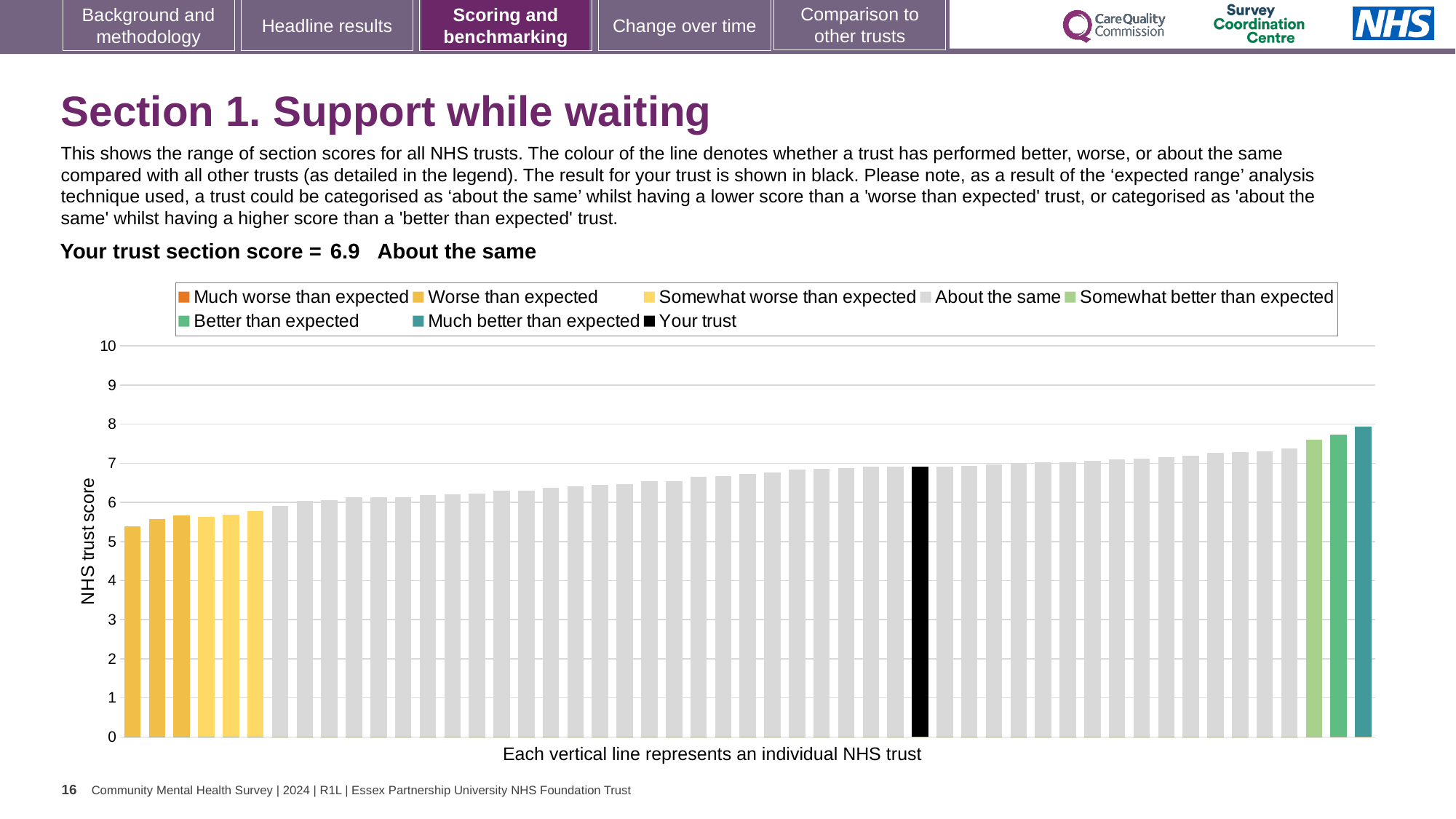
How many entries does the chart legend list? 8 What is the label on the vertical axis of the chart? NHS trust score Is the value of the highest bar in the chart greater or less than 7? greater How many bars are coloured as 'Much better than expected'? 1 Is the value of the lowest bar in the chart greater or less than 6? less What is the section score for your trust shown on the slide? 6.9 What kind of chart is shown on the slide? bar chart Is the value of the black 'Your trust' bar greater or less than 7? less Do the bar values rise or fall from left to right across the chart? rise How many bars are coloured as 'Better than expected'? 1 Which category is your trust placed in for this section? About the same What colour is the bar representing your trust? black